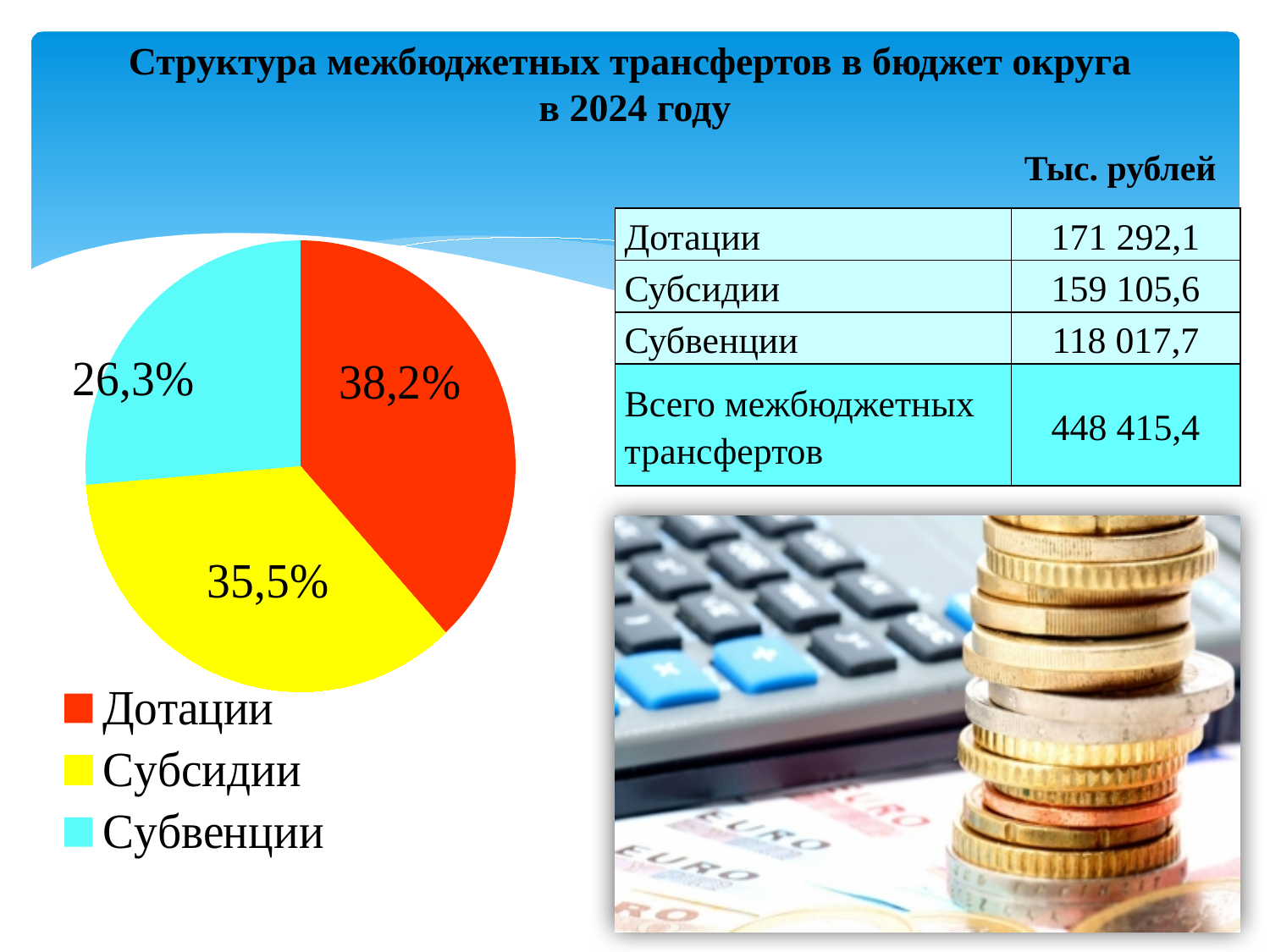
What share of the pie chart does Субсидии represent? 35,5% Which category has the largest slice in the pie chart? Дотации What colour represents Субвенции in the pie chart? Cyan (light blue) How many categories are shown in the pie chart? 3 Which category has the smallest slice in the pie chart? Субвенции Which category is shown in yellow in the pie chart? Субсидии What is the difference in percentage points between the Дотации slice and the Субвенции slice? 11,9 Which slice is larger, Субсидии or Субвенции? Субсидии What is the difference in percentage points between the Дотации slice and the Субсидии slice? 2,7 What kind of chart is shown on the slide? Pie chart What share of the pie chart does Дотации represent? 38,2% What share of the pie chart does Субвенции represent? 26,3%